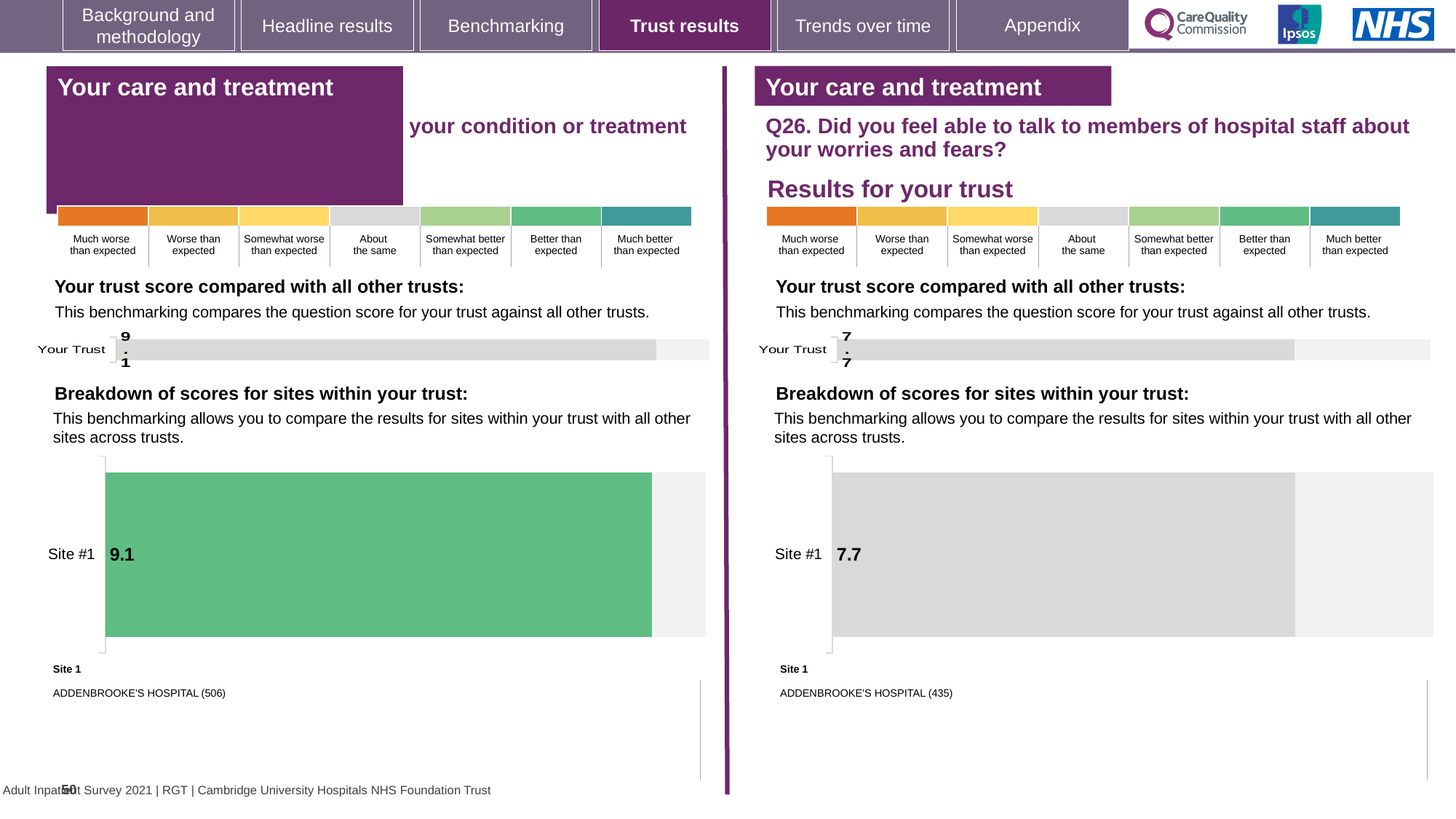
On the right-hand side of the slide (Q26), what is the score shown for Your Trust in the trust score chart? 7.7 In the right-hand site breakdown chart for Q26, what is the score for Site #1? 7.7 In the left-hand site breakdown chart, what is the score for Site #1? 9.1 What is the difference between the Site #1 score in the left-hand breakdown chart and the Site #1 score in the right-hand breakdown chart? 1.4 What kind of chart is used for the site breakdown on the right-hand side of the slide? Bar chart Which is larger: the Your Trust score on the left-hand side of the slide or the Your Trust score on the right-hand side (Q26)? The left-hand side (9.1) How many sites are shown in the left-hand site breakdown chart? 1 On the left-hand side of the slide, what is the score shown for Your Trust in the trust score chart? 9.1 Is the Site #1 score in the left-hand breakdown chart greater or less than the Site #1 score in the right-hand breakdown chart? greater How many sites are shown in the right-hand site breakdown chart for Q26? 1 Which site name is listed under the right-hand site breakdown chart for Q26? ADDENBROOKE'S HOSPITAL (435) Which site name is listed under the left-hand site breakdown chart? ADDENBROOKE'S HOSPITAL (506)